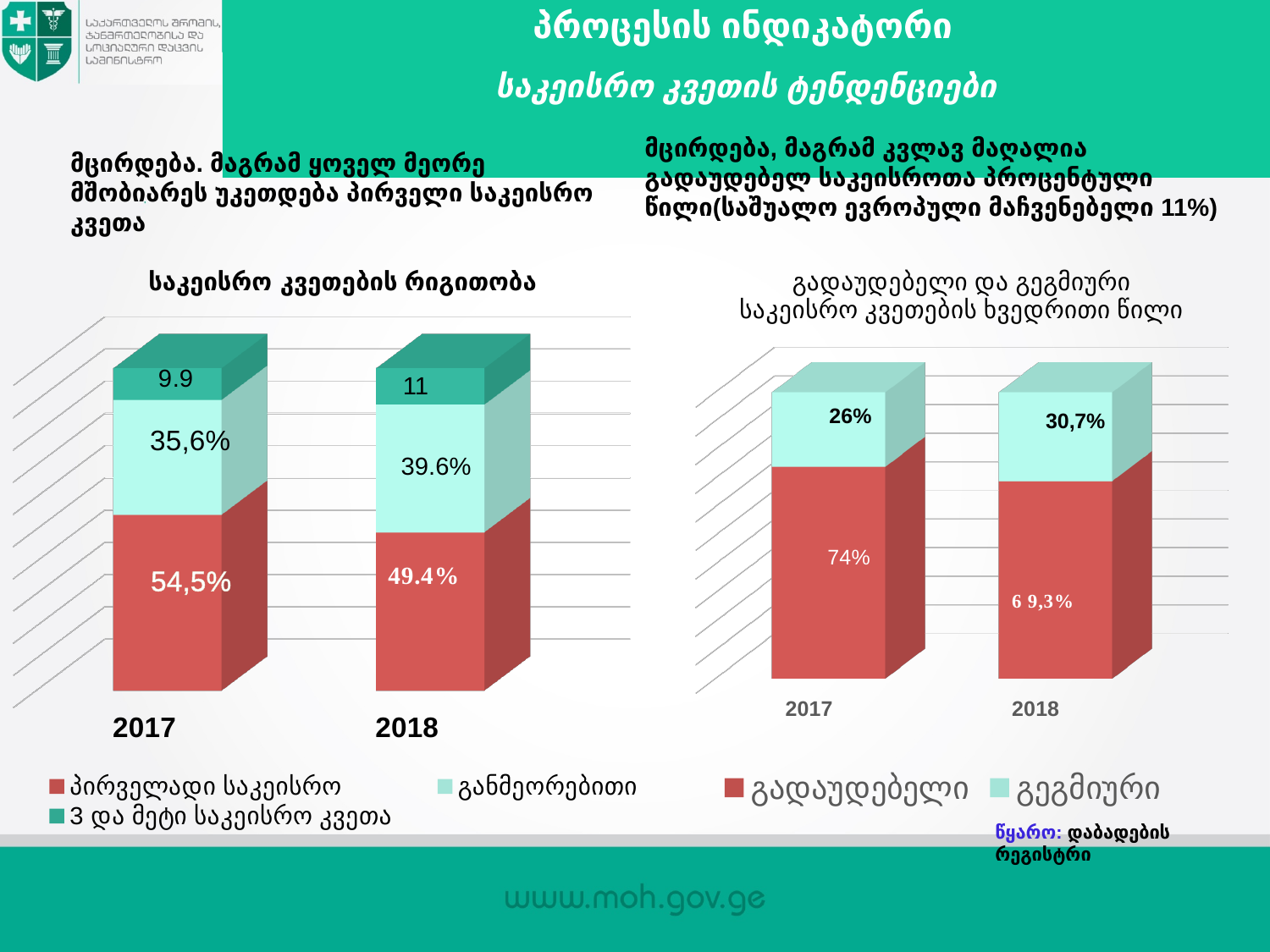
In the right chart (გადაუდებელი და გეგმიური საკეისრო კვეთების ხვედრითი წილი), what is the value for გეგმიური in 2018? 30,7% In the left chart (საკეისრო კვეთების რიგითობა), does the value for პირველადი საკეისრო rise or fall from 2017 to 2018? fall What kind of chart is the right chart (გადაუდებელი და გეგმიური საკეისრო კვეთების ხვედრითი წილი)? stacked bar chart In the left chart (საკეისრო კვეთების რიგითობა), what is the value for 3 და მეტი საკეისრო კვეთა in 2017? 9.9 In the right chart (გადაუდებელი და გეგმიური საკეისრო კვეთების ხვედრითი წილი), what is the value for გადაუდებელი in 2017? 74% In the right chart (გადაუდებელი და გეგმიური საკეისრო კვეთების ხვედრითი წილი), how many categories are shown on the x axis? 2 In the left chart (საკეისრო კვეთების რიგითობა), which is larger in 2018: განმეორებითი or 3 და მეტი საკეისრო კვეთა? განმეორებითი In the left chart (საკეისრო კვეთების რიგითობა), how many series does the legend list? 3 In the right chart (გადაუდებელი და გეგმიური საკეისრო კვეთების ხვედრითი წილი), which series is shown in red? გადაუდებელი In the left chart (საკეისრო კვეთების რიგითობა), what is the value for განმეორებითი in 2018? 39.6% In the right chart (გადაუდებელი და გეგმიური საკეისრო კვეთების ხვედრითი წილი), what is the difference between the გეგმიური values for 2018 and 2017? 4,7% In the left chart (საკეისრო კვეთების რიგითობა), what is the value for პირველადი საკეისრო in 2017? 54,5%